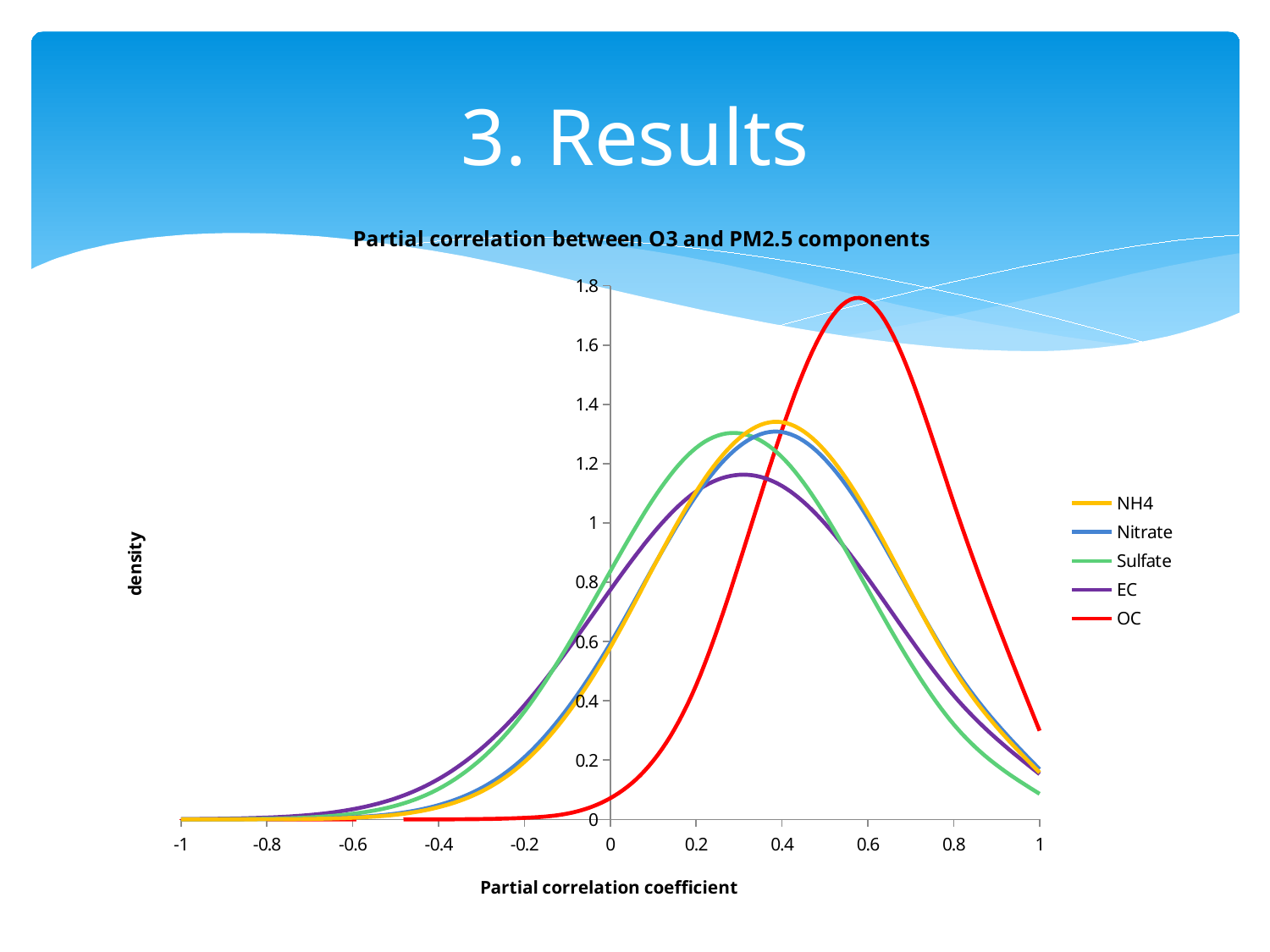
Is the peak density of the OC curve greater or less than 1.6? greater Which has a higher peak density, the OC curve or the NH4 curve? OC Is the density of the Sulfate curve at a partial correlation coefficient of 1 greater or less than 0.2? less Which series reaches the highest peak density? OC What is the label of the x axis? Partial correlation coefficient Which series has the lowest peak density? EC Is the peak density of the EC curve greater or less than 1.2? less What is the title of the chart? Partial correlation between O3 and PM2.5 components What kind of chart is shown on the slide? line chart Does the OC curve rise or fall between a partial correlation coefficient of 0.6 and 1? fall How many series does the legend list? 5 Does the Sulfate curve rise or fall between a partial correlation coefficient of -1 and 0.2? rise